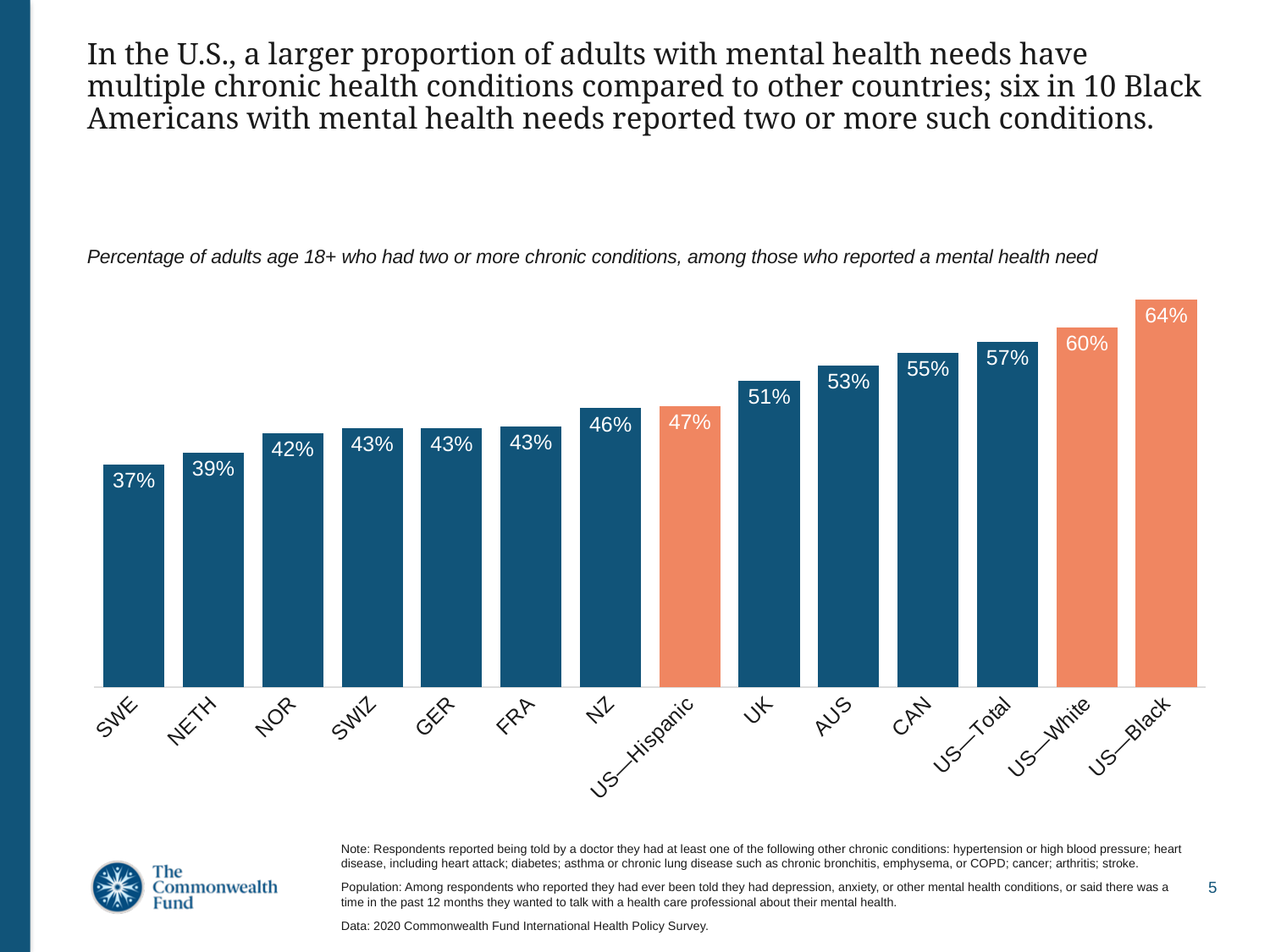
Which category has the highest value? US—Black What is the value for CAN? 55% What kind of chart is this? Bar chart Which category has the lowest value? SWE Which is larger, the value for UK or the value for NZ? UK What is the value for SWE? 37% What is the difference between the values for US—Total and SWE? 20% Do the values rise or fall from left to right along the x axis? Rise What is the difference between the values for US—Black and US—White? 4% How many bars are shown in orange rather than blue? 3 How many categories are shown on the x axis? 14 What is the value for US—Hispanic? 47%